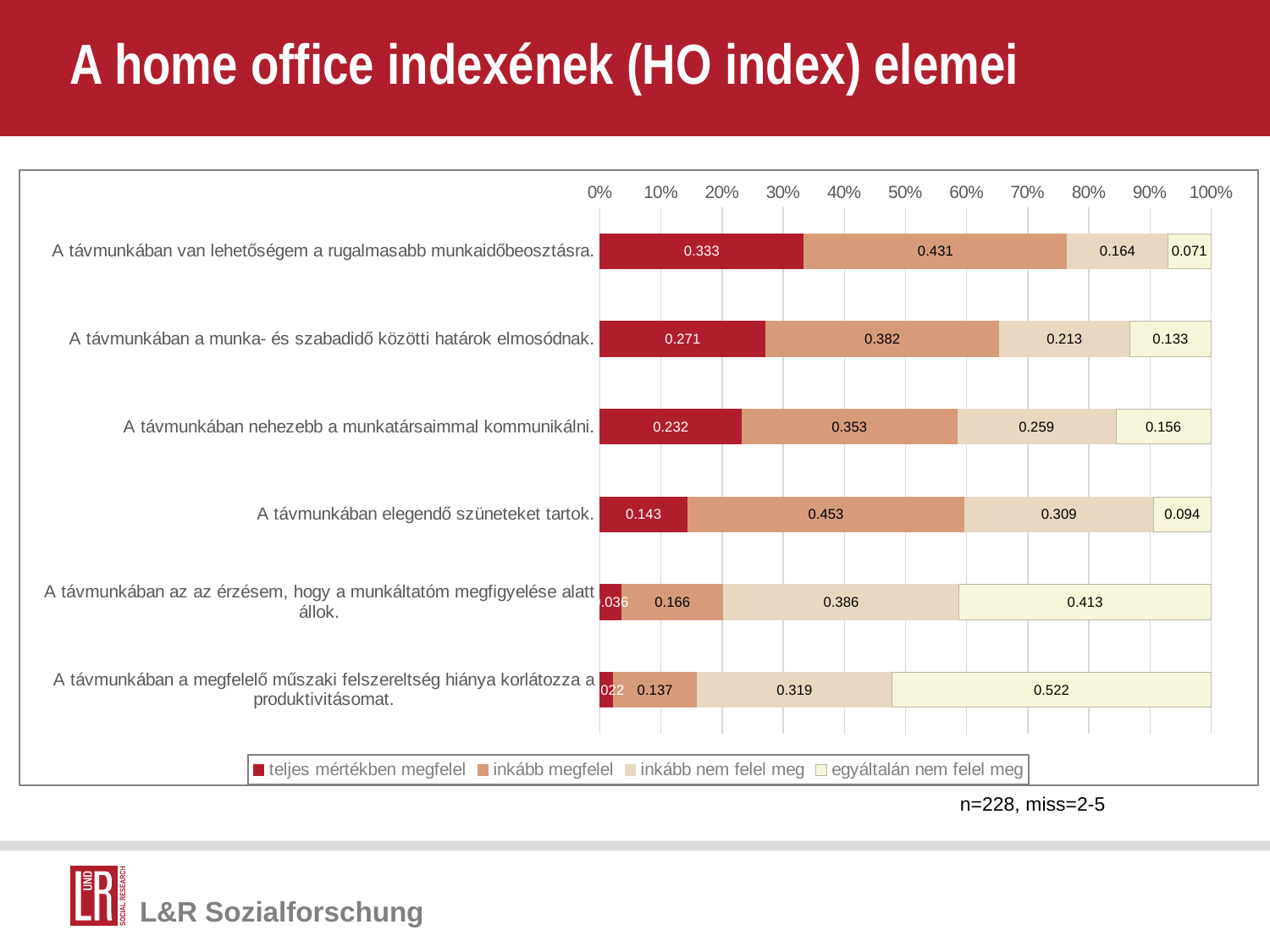
Which statement has the lowest 'egyáltalán nem felel meg' value? A távmunkában van lehetőségem a rugalmasabb munkaidőbeosztásra. What is the 'inkább megfelel' value for 'A távmunkában elegendő szüneteket tartok.'? 0.453 What is the difference between the 'inkább megfelel' values for 'A távmunkában a munka- és szabadidő közötti határok elmosódnak.' and 'A távmunkában nehezebb a munkatársaimmal kommunikálni.'? 0.029 What is the 'teljes mértékben megfelel' value for 'A távmunkában van lehetőségem a rugalmasabb munkaidőbeosztásra.'? 0.333 How many statements (categories) are plotted in the chart? 6 What kind of chart is shown on the slide? Stacked bar chart What is the 'egyáltalán nem felel meg' value for 'A távmunkában a megfelelő műszaki felszereltség hiánya korlátozza a produktivitásomat.'? 0.522 What is the 'inkább nem felel meg' value for 'A távmunkában nehezebb a munkatársaimmal kommunikálni.'? 0.259 How many series does the legend list? 4 What sample size note is shown below the chart? n=228, miss=2-5 Which statement has the highest 'teljes mértékben megfelel' value? A távmunkában van lehetőségem a rugalmasabb munkaidőbeosztásra. Which is larger: the 'egyáltalán nem felel meg' value for 'A távmunkában az az érzésem, hogy a munkáltatóm megfigyelése alatt állok.' or for 'A távmunkában a megfelelő műszaki felszereltség hiánya korlátozza a produktivitásomat.'? A távmunkában a megfelelő műszaki felszereltség hiánya korlátozza a produktivitásomat.